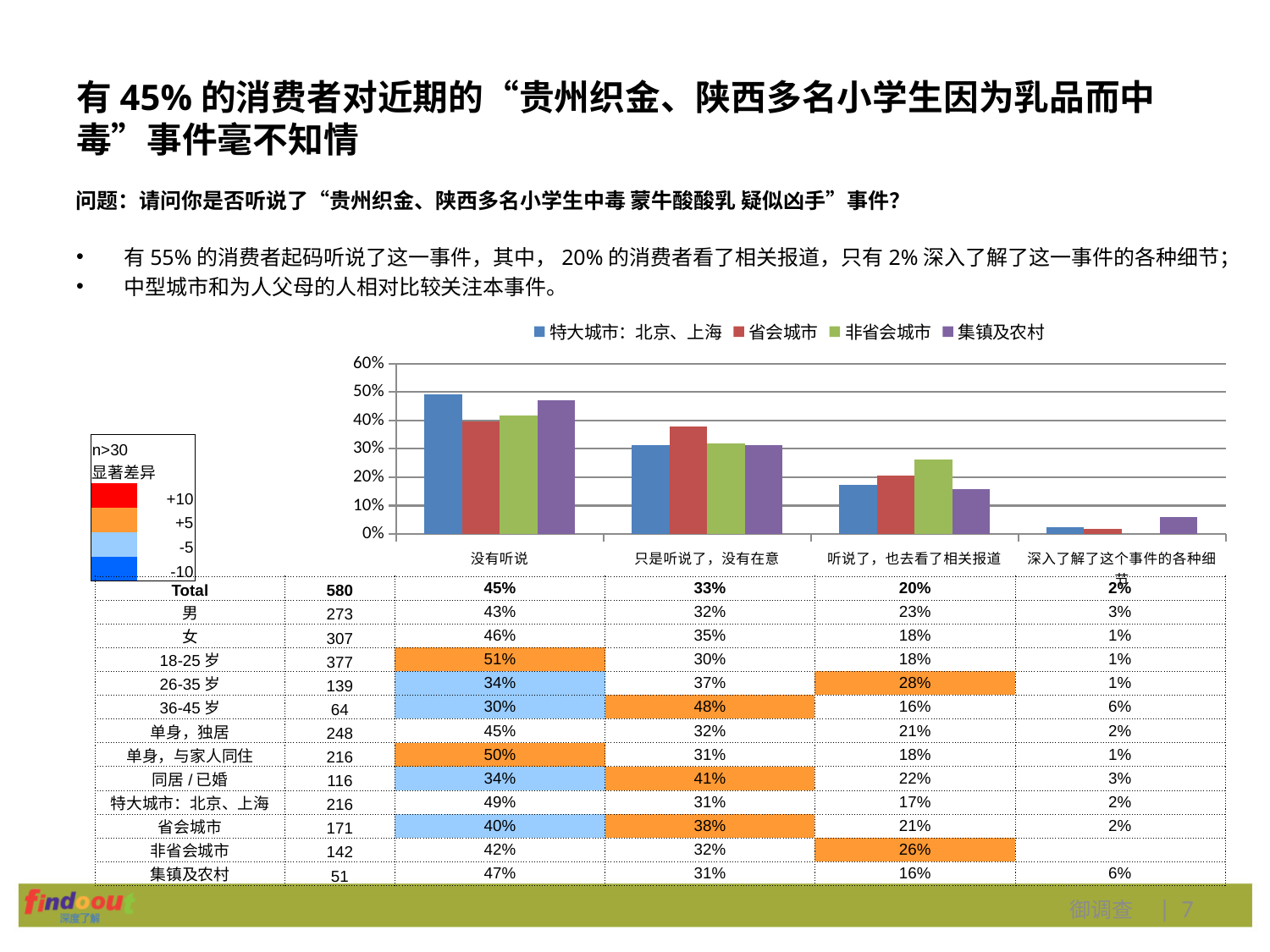
How many series does the chart legend list? 4 Do the values for 特大城市：北京、上海 rise or fall from left to right across the categories? fall Which series has the highest value in the 深入了解了这个事件的各种细节 category? 集镇及农村 In the 只是听说了，没有在意 category, which is larger: 省会城市 or 特大城市：北京、上海? 省会城市 What is the value for 特大城市：北京、上海 in the 没有听说 category? 49% Which series has the highest value in the 听说了，也去看了相关报道 category? 非省会城市 Which series has the highest value in the 没有听说 category? 特大城市：北京、上海 Is the value for 集镇及农村 in the 没有听说 category greater or less than 40%? greater What kind of chart is shown on the slide? bar chart What is the difference between 特大城市：北京、上海 and 省会城市 in the 没有听说 category? 9 percentage points What is the value for 集镇及农村 in the 深入了解了这个事件的各种细节 category? 6% How many categories are shown along the x axis of the chart? 4